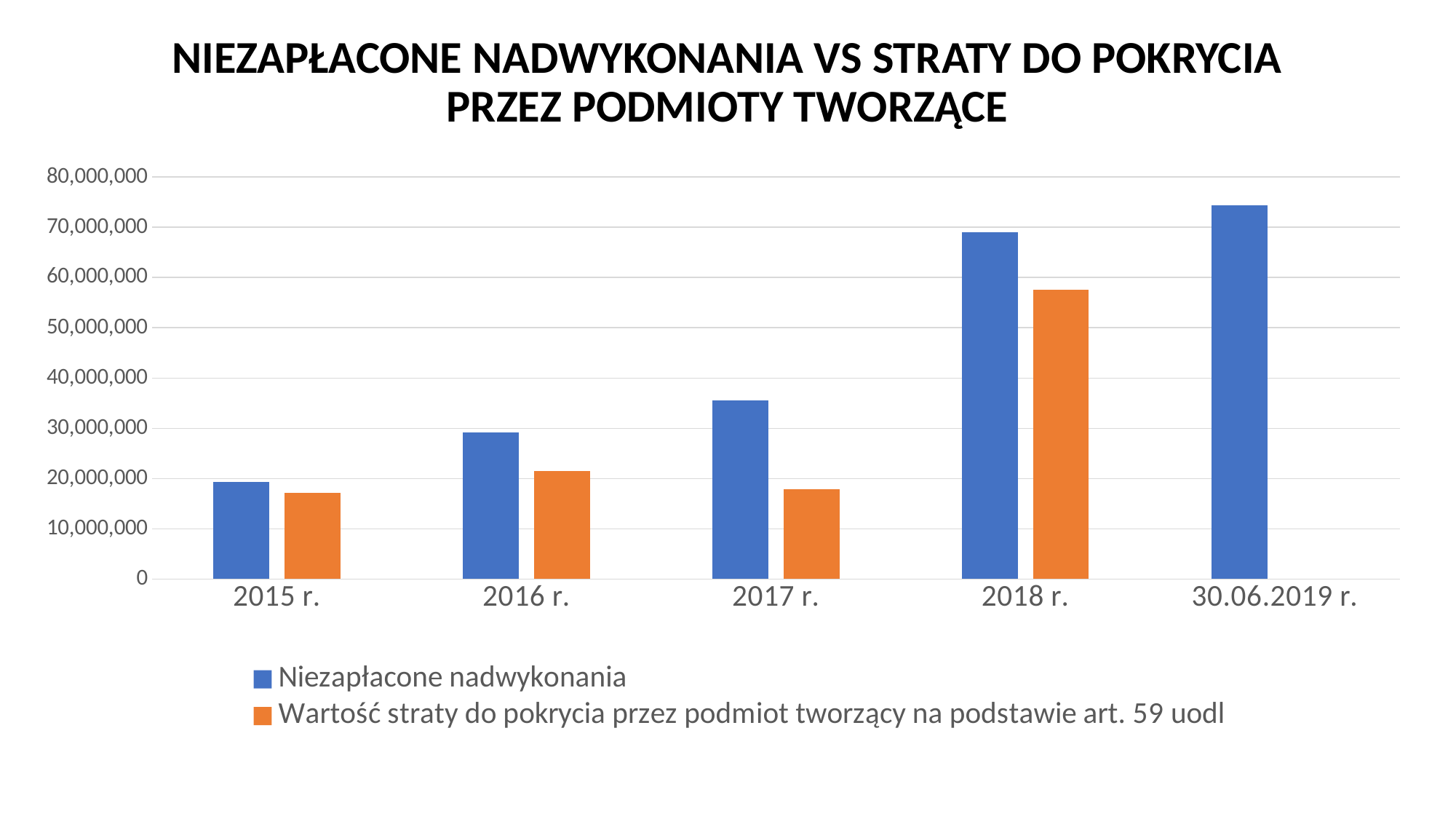
Is the value for Niezapłacone nadwykonania in 30.06.2019 r. greater or less than 70,000,000? greater Which category has the highest value for Niezapłacone nadwykonania? 30.06.2019 r. Which colour represents Niezapłacone nadwykonania in the chart? blue Which category has the highest value for Wartość straty do pokrycia przez podmiot tworzący na podstawie art. 59 uodl? 2018 r. How many series does the legend list? 2 Do the values for Niezapłacone nadwykonania rise or fall from 2015 r. to 30.06.2019 r.? rise Is the value for Wartość straty do pokrycia przez podmiot tworzący na podstawie art. 59 uodl in 2018 r. greater or less than 60,000,000? less Is the value for Niezapłacone nadwykonania in 2017 r. greater or less than 30,000,000? greater How many categories are shown on the x axis? 5 What kind of chart is shown on the slide? bar chart Which category has the lowest value for Niezapłacone nadwykonania? 2015 r. Which is larger in 2017 r.: Niezapłacone nadwykonania or Wartość straty do pokrycia przez podmiot tworzący na podstawie art. 59 uodl? Niezapłacone nadwykonania